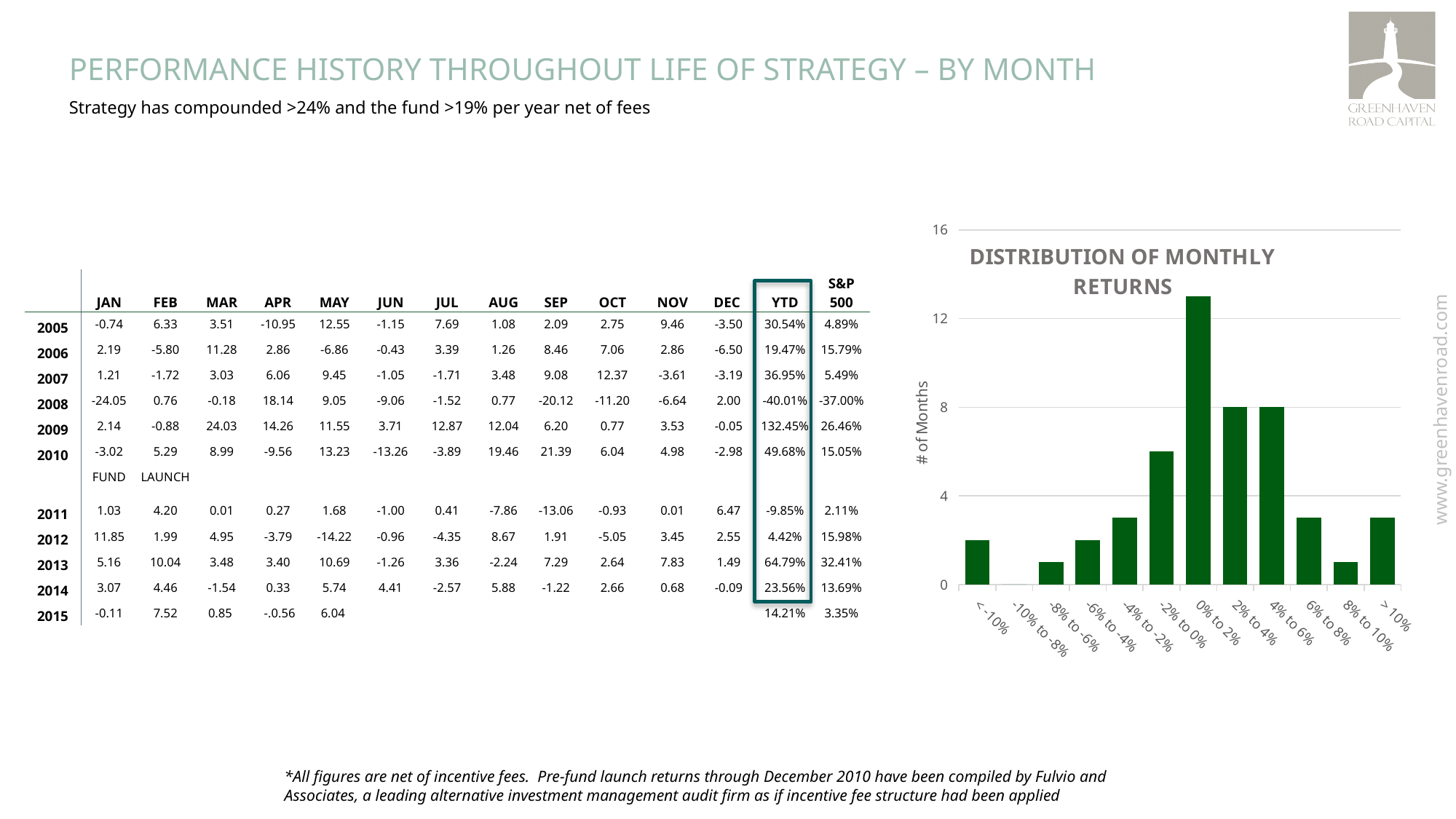
In the 'Distribution of Monthly Returns' chart, which has more months: the -2% to 0% range or the -4% to -2% range? -2% to 0% In the 'Distribution of Monthly Returns' chart, how many months fall in the 4% to 6% range? 8 In the 'Distribution of Monthly Returns' chart, is the number of months in the 0% to 2% range greater or less than 12? greater In the 'Distribution of Monthly Returns' chart, which return range has the lowest number of months? -10% to -8% In the 'Distribution of Monthly Returns' chart, which return range has the highest number of months? 0% to 2% What is the label on the vertical axis of the 'Distribution of Monthly Returns' chart? # of Months In the 'Distribution of Monthly Returns' chart, is the number of months in the < -10% range greater or less than 4? less In the 'Distribution of Monthly Returns' chart, is the number of months in the -2% to 0% range greater or less than 4? greater What type of chart is 'Distribution of Monthly Returns'? bar chart How many return-range categories are shown on the x axis of the 'Distribution of Monthly Returns' chart? 12 In the 'Distribution of Monthly Returns' chart, do the bars rise or fall moving from the -8% to -6% range to the 0% to 2% range? rise In the 'Distribution of Monthly Returns' chart, how many months fall in the 2% to 4% range? 8